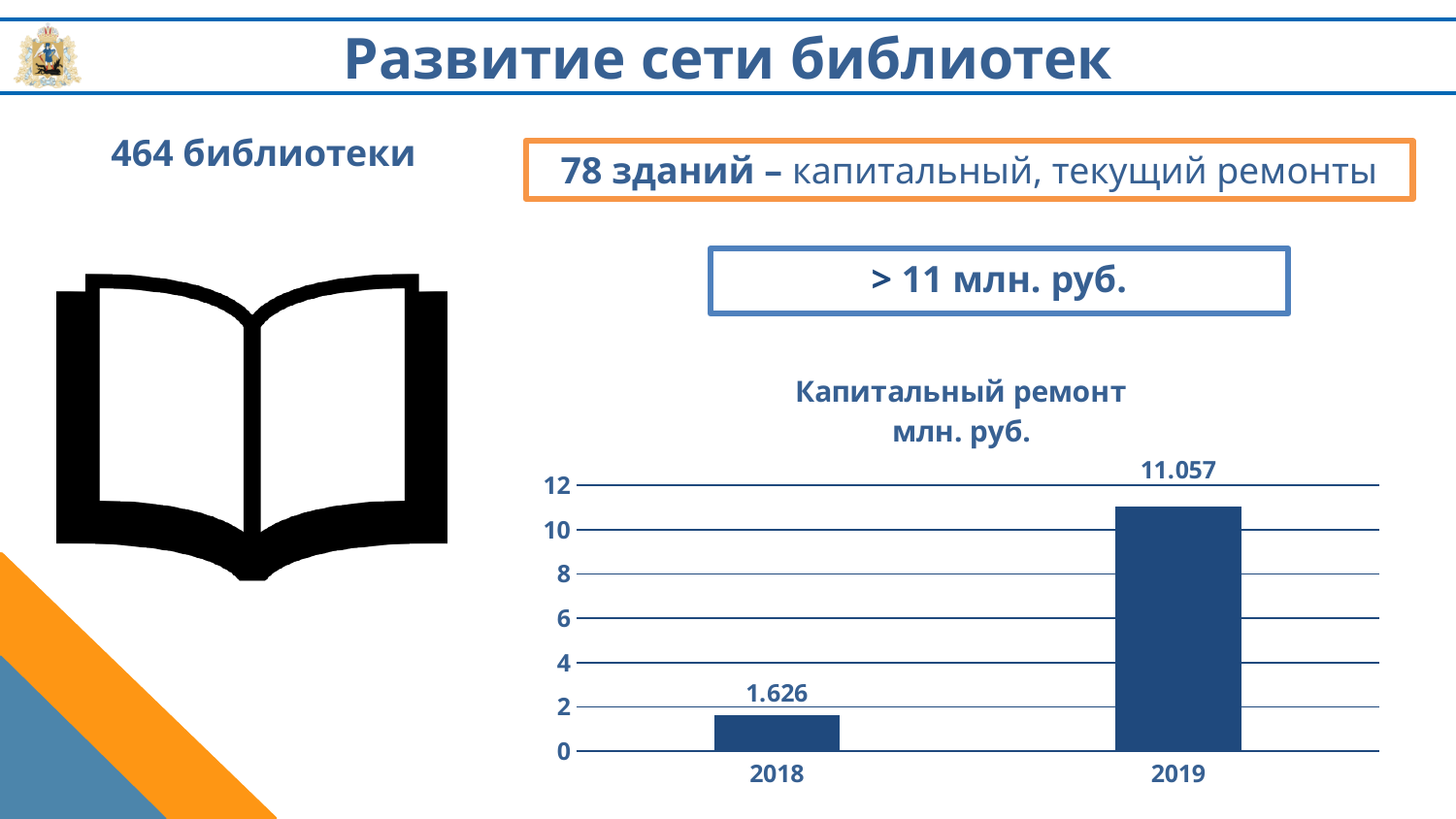
What kind of chart is shown on the slide? bar chart Is the value for 2018 greater or less than 2? less How many years are shown on the x axis of the chart? 2 What is the value for 2019 in the chart? 11.057 Which year has the lowest value in the chart? 2018 Do the values rise or fall from 2018 to 2019? rise Which is larger, the value for 2018 or the value for 2019? 2019 What is the difference between the 2019 and 2018 values in the chart? 9.431 Which year has the highest value in the chart? 2019 What is the title of the chart? Капитальный ремонт млн. руб. What is the value for 2018 in the chart? 1.626 Is the value for 2019 greater or less than 10? greater